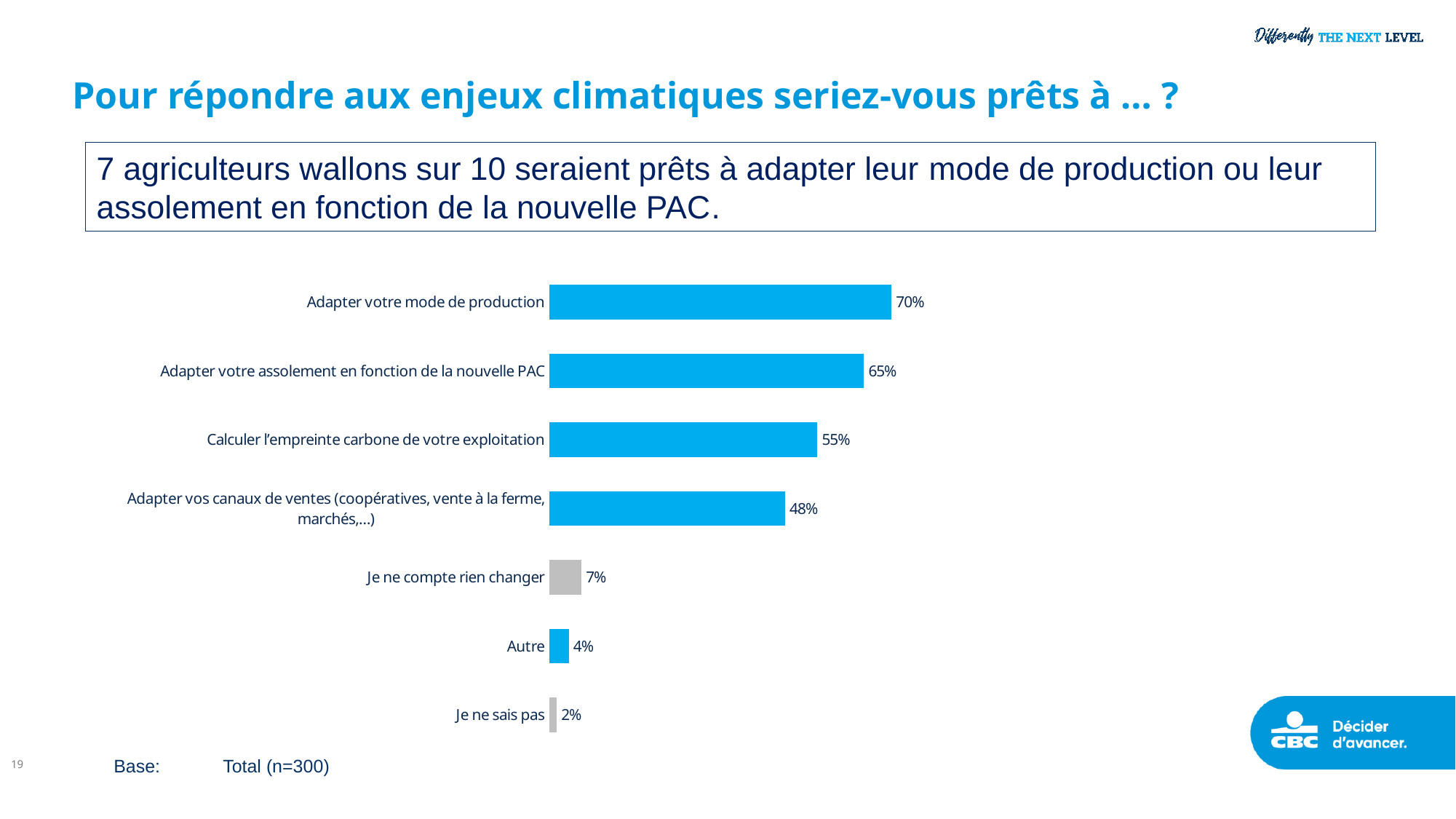
What is the value for 'Adapter vos canaux de ventes (coopératives, vente à la ferme, marchés,...)'? 48% What is the base (sample size) indicated at the bottom of the slide? Total (n=300) What percentage of respondents would be willing to 'Adapter votre mode de production'? 70% What is the difference between 'Adapter votre mode de production' and 'Adapter votre assolement en fonction de la nouvelle PAC'? 5% Which category has the highest value? Adapter votre mode de production What is the difference between 'Je ne compte rien changer' and 'Autre'? 3% What is the value for 'Calculer l'empreinte carbone de votre exploitation'? 55% How many categories are shown in the chart? 7 What percentage is shown for 'Je ne compte rien changer'? 7% Which is larger: 'Calculer l'empreinte carbone de votre exploitation' or 'Adapter vos canaux de ventes (coopératives, vente à la ferme, marchés,...)'? Calculer l'empreinte carbone de votre exploitation Which category has the lowest value? Je ne sais pas What type of chart is shown on the slide? Bar chart